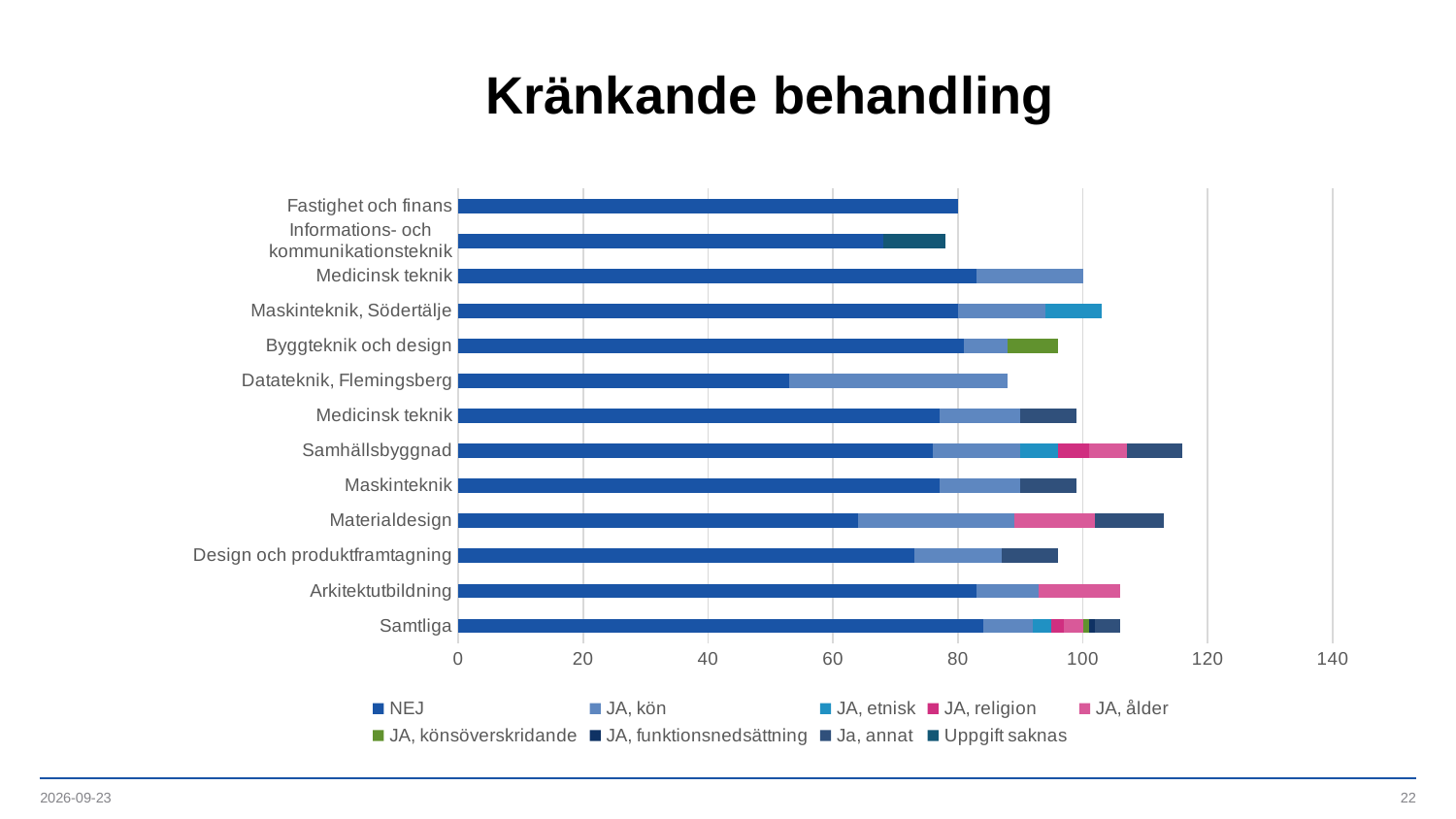
How many categories are plotted on the vertical axis of the chart? 13 What type of chart is shown on the slide? bar chart What is the title of the chart? Kränkande behandling Is the total bar length for Byggteknik och design greater or less than 100? less Is the NEJ segment for Datateknik, Flemingsberg greater or less than 60? less Is the total bar length for Materialdesign greater or less than 100? greater Which category has the shortest NEJ segment? Datateknik, Flemingsberg How many series does the legend list? 9 Which series is shown in green in the legend? JA, könsöverskridande Which has the longer total bar, Samhällsbyggnad or Datateknik, Flemingsberg? Samhällsbyggnad